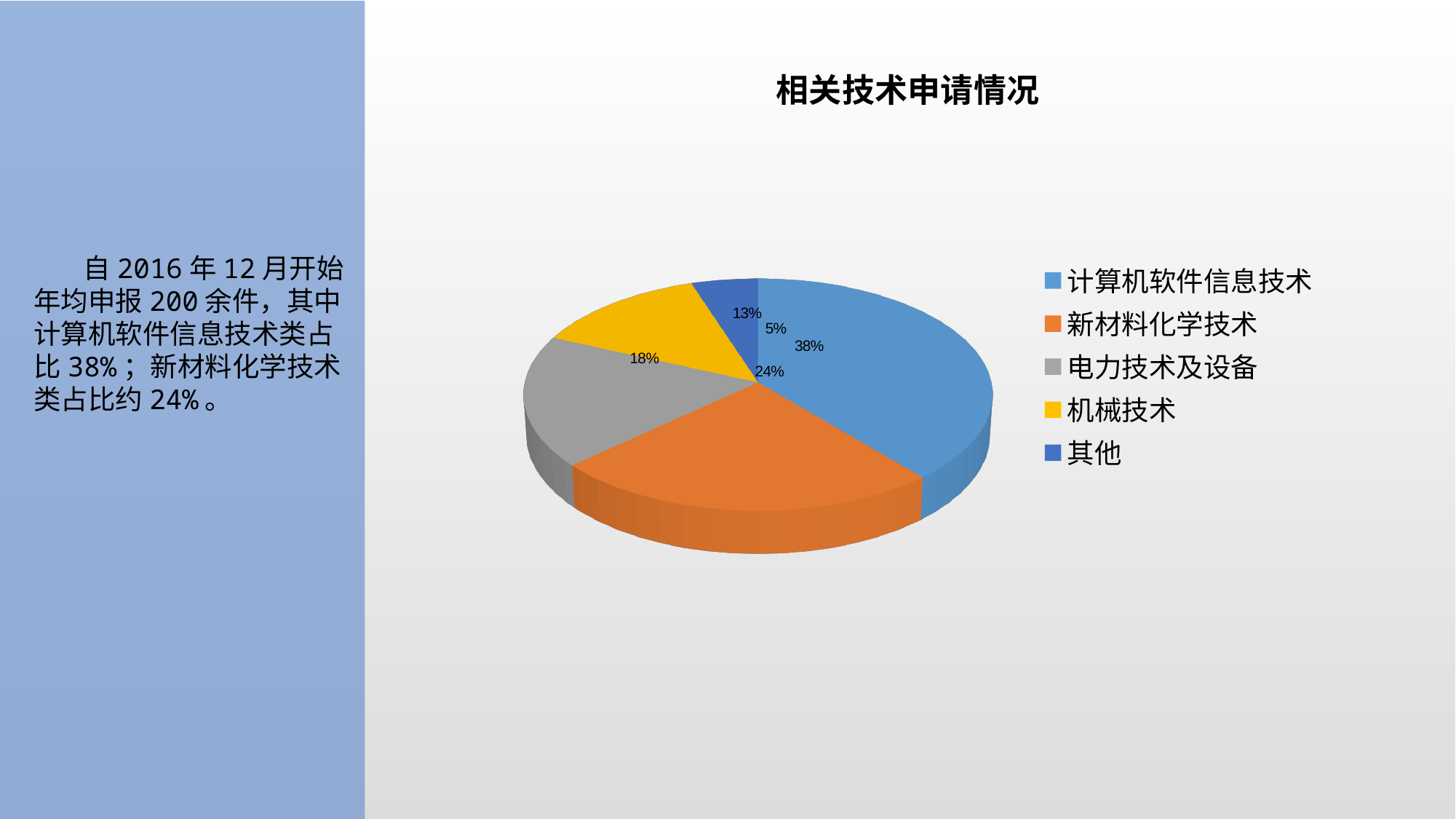
What share of the pie does 计算机软件信息技术 have? 38% What share of the pie does 其他 have? 5% What is the title of the pie chart? 相关技术申请情况 What is the difference in percentage points between 计算机软件信息技术 and 新材料化学技术? 14 What share of the pie does 机械技术 have? 13% Which category has the smallest share of the pie? 其他 Which category has the largest share of the pie? 计算机软件信息技术 What type of chart is shown on the slide? pie chart Which has a larger share, 电力技术及设备 or 机械技术? 电力技术及设备 How many slices does the pie chart have? 5